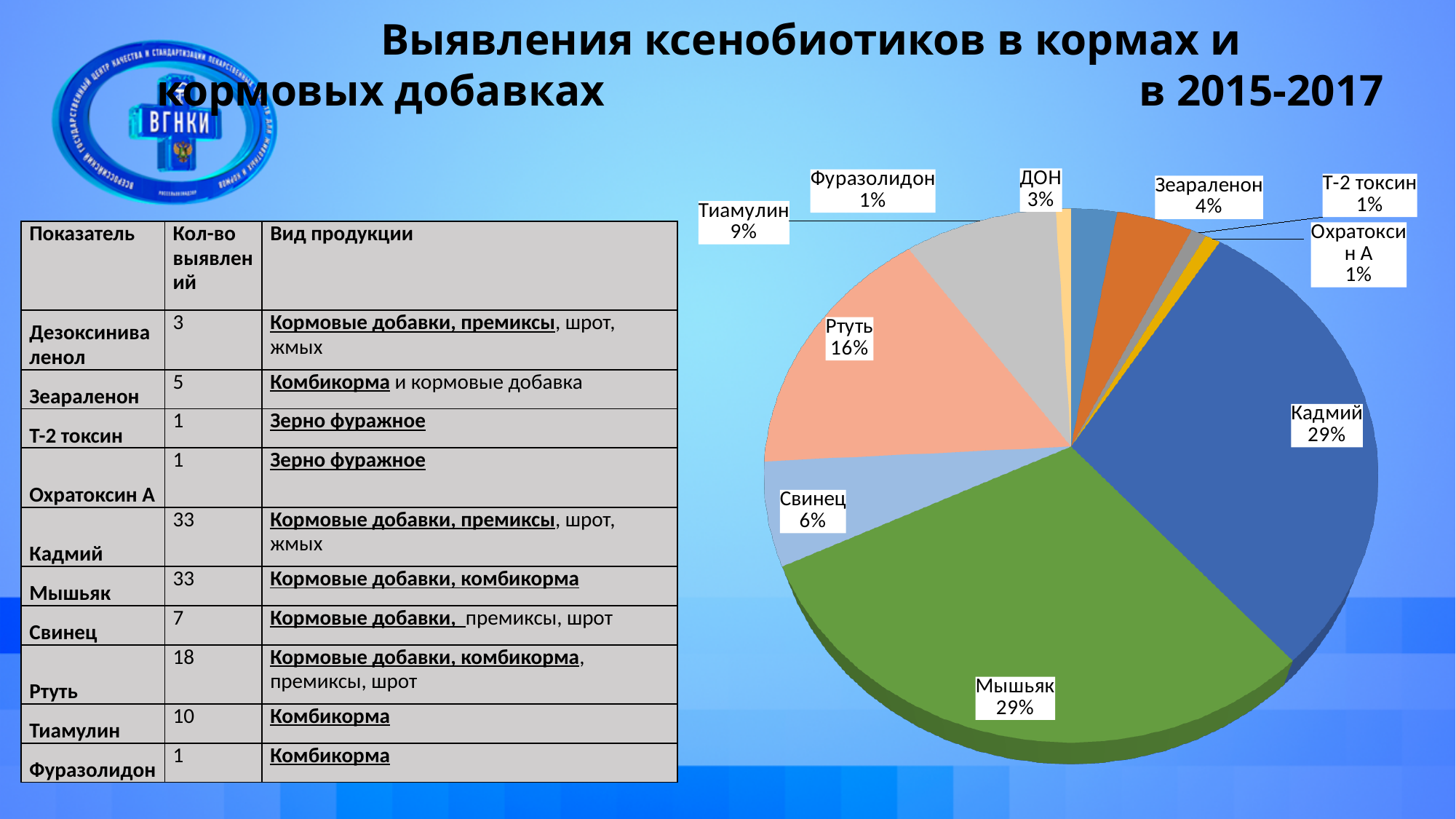
How many slices does the pie chart have? 10 What share of the pie does Зеараленон account for? 4% What share of the pie does Охратоксин А account for? 1% What share of the pie does Свинец account for? 6% What is the difference between the shares for Кадмий and Ртуть? 13% What is the difference between the shares for Ртуть and Свинец? 10% What kind of chart is shown on the slide? pie chart Which is larger, the share for Ртуть or the share for Тиамулин? Ртуть